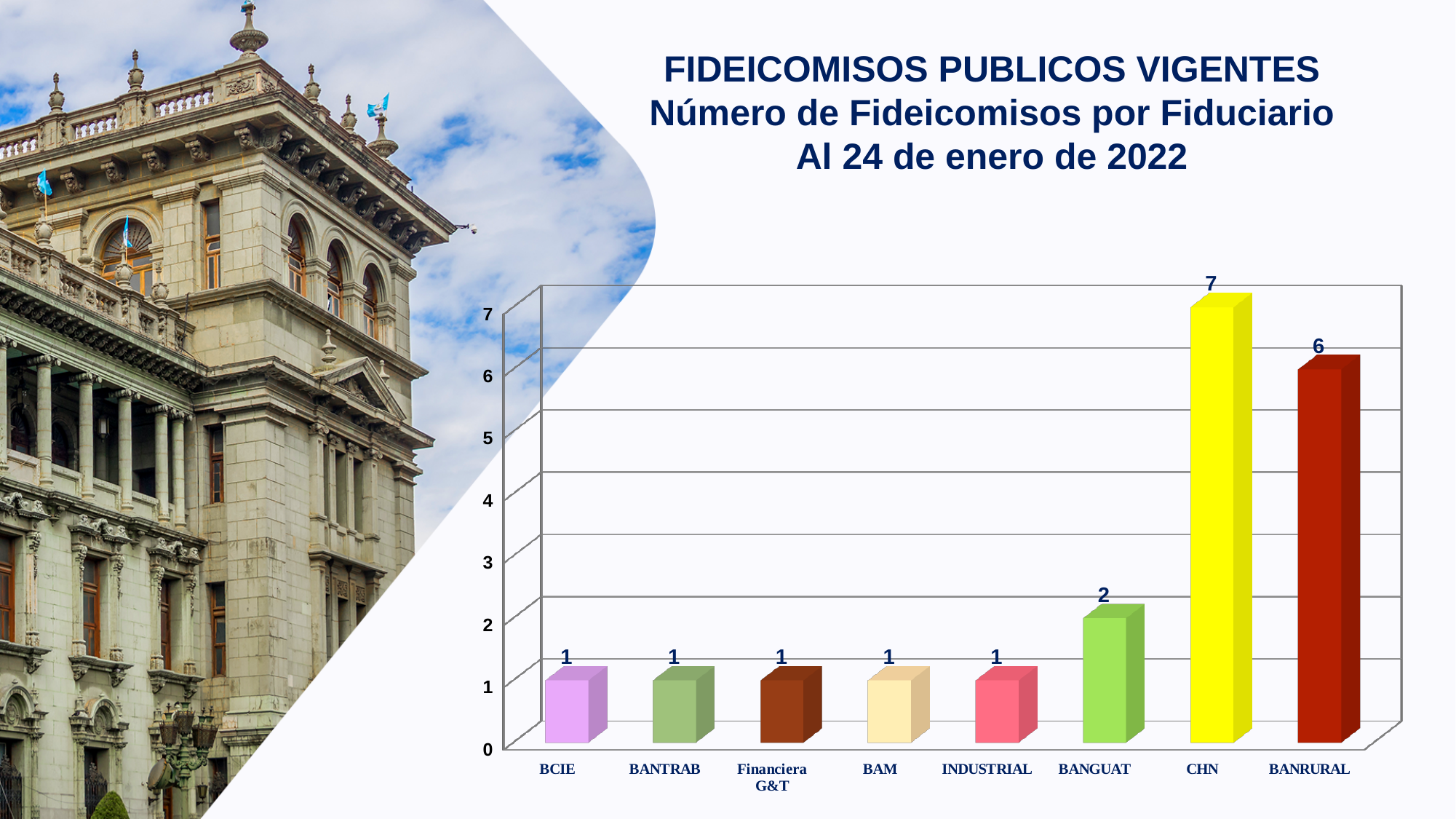
What is the number of fideicomisos for CHN? 7 What is the number of fideicomisos for BANRURAL? 6 What is the difference between the values for CHN and BANRURAL? 1 How many fiduciarios are shown on the x axis? 8 Which fiduciario has the highest number of fideicomisos? CHN What is the number of fideicomisos for BANGUAT? 2 Which has a larger value, BANGUAT or INDUSTRIAL? BANGUAT What is the number of fideicomisos for Financiera G&T? 1 What is the difference between the values for BANRURAL and BANGUAT? 4 How many fiduciarios have a value of 1? 5 What kind of chart is shown on the slide? Bar chart What is the date stated in the chart title? 24 de enero de 2022